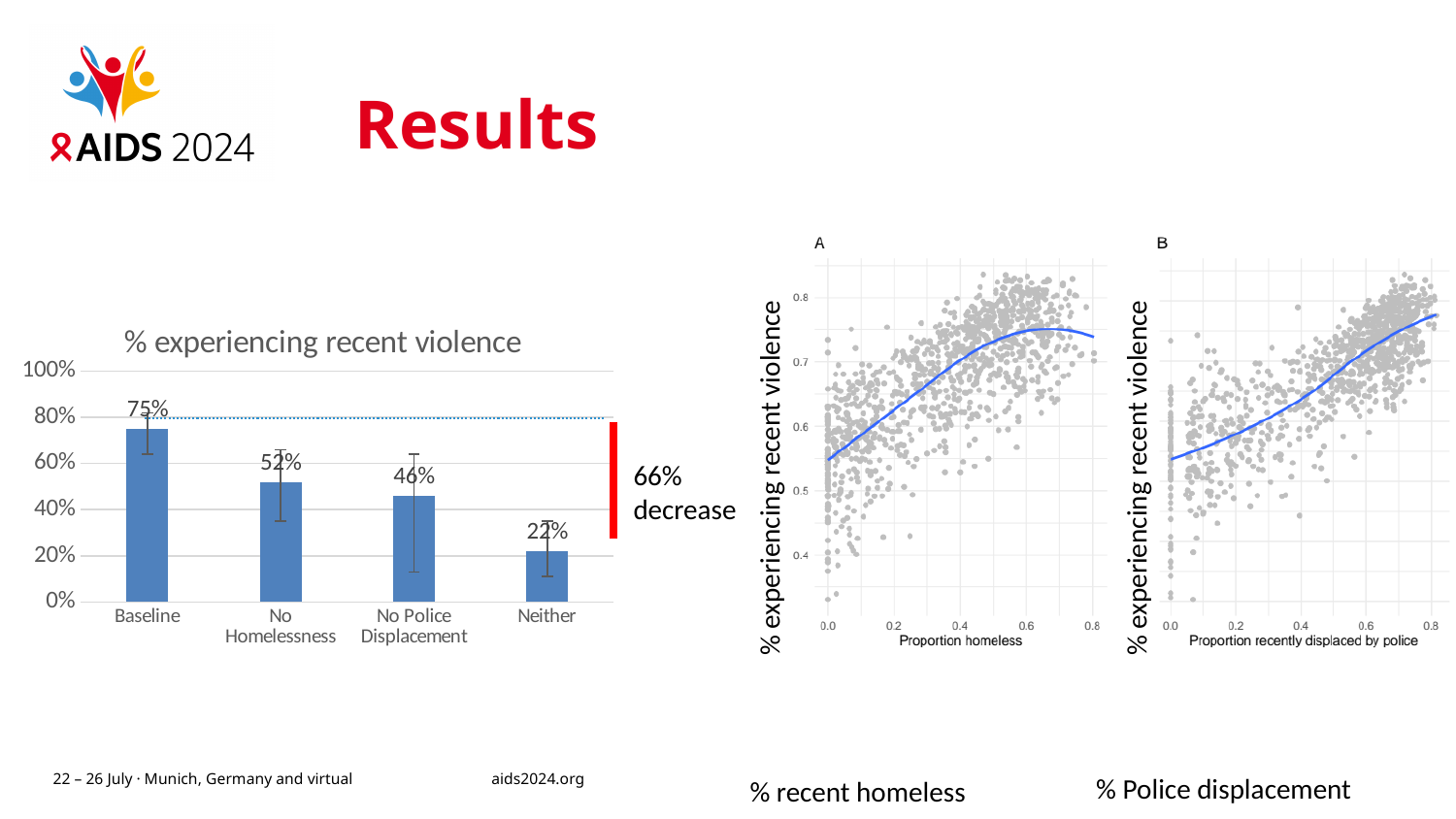
In the bar chart titled '% experiencing recent violence', which is larger, the value for No Homelessness or the value for No Police Displacement? No Homelessness In the bar chart titled '% experiencing recent violence', which category has the highest value? Baseline In the bar chart titled '% experiencing recent violence', what is the value for Baseline? 75% In the bar chart titled '% experiencing recent violence', what is the value for No Police Displacement? 46% How many categories are shown in the bar chart titled '% experiencing recent violence'? 4 In the bar chart titled '% experiencing recent violence', what is the value for No Homelessness? 52% What is the x-axis label of scatter plot B on the right of the slide? Proportion recently displaced by police In the bar chart titled '% experiencing recent violence', do the values rise or fall from Baseline to Neither along the x axis? Fall What kind of chart is the chart titled '% experiencing recent violence'? Bar chart In the bar chart titled '% experiencing recent violence', what is the value for Neither? 22% In the bar chart titled '% experiencing recent violence', which category has the lowest value? Neither In the bar chart titled '% experiencing recent violence', what is the difference between the Baseline value and the Neither value? 53%